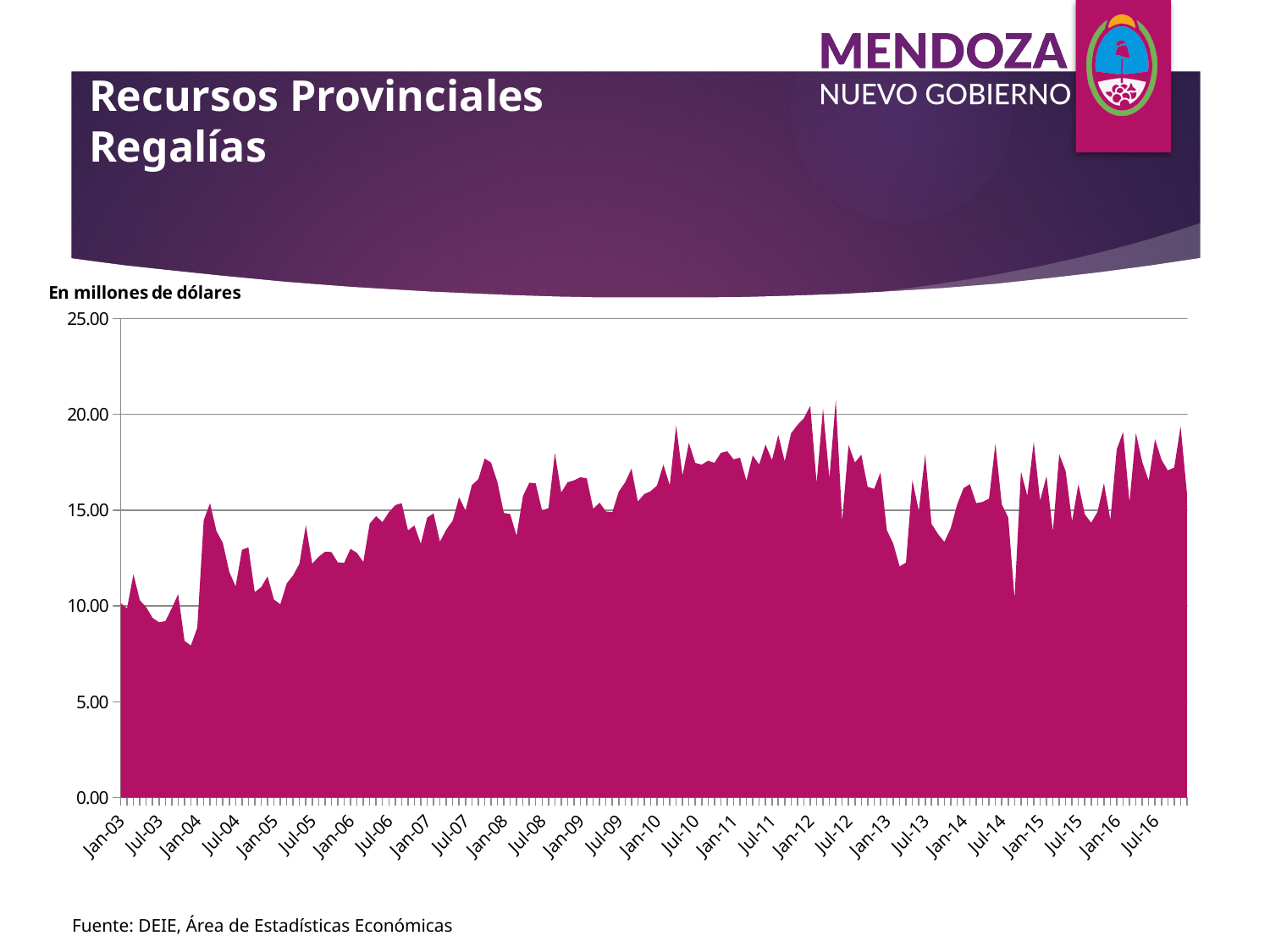
What kind of chart is shown on the slide? Area chart Is the value for Jan-04 greater or less than 10.00? less What unit is stated above the chart for the plotted values? En millones de dólares Is the value for Jul-10 greater or less than 15.00? greater What is the title of the slide containing the chart? Recursos Provinciales Regalías Is the highest value reached by the series greater or less than 20.00? greater Overall, do the values rise or fall from Jan-03 to the end of the series in 2016? rise Which is larger, the value for Jan-04 or the value for Jan-08? Jan-08